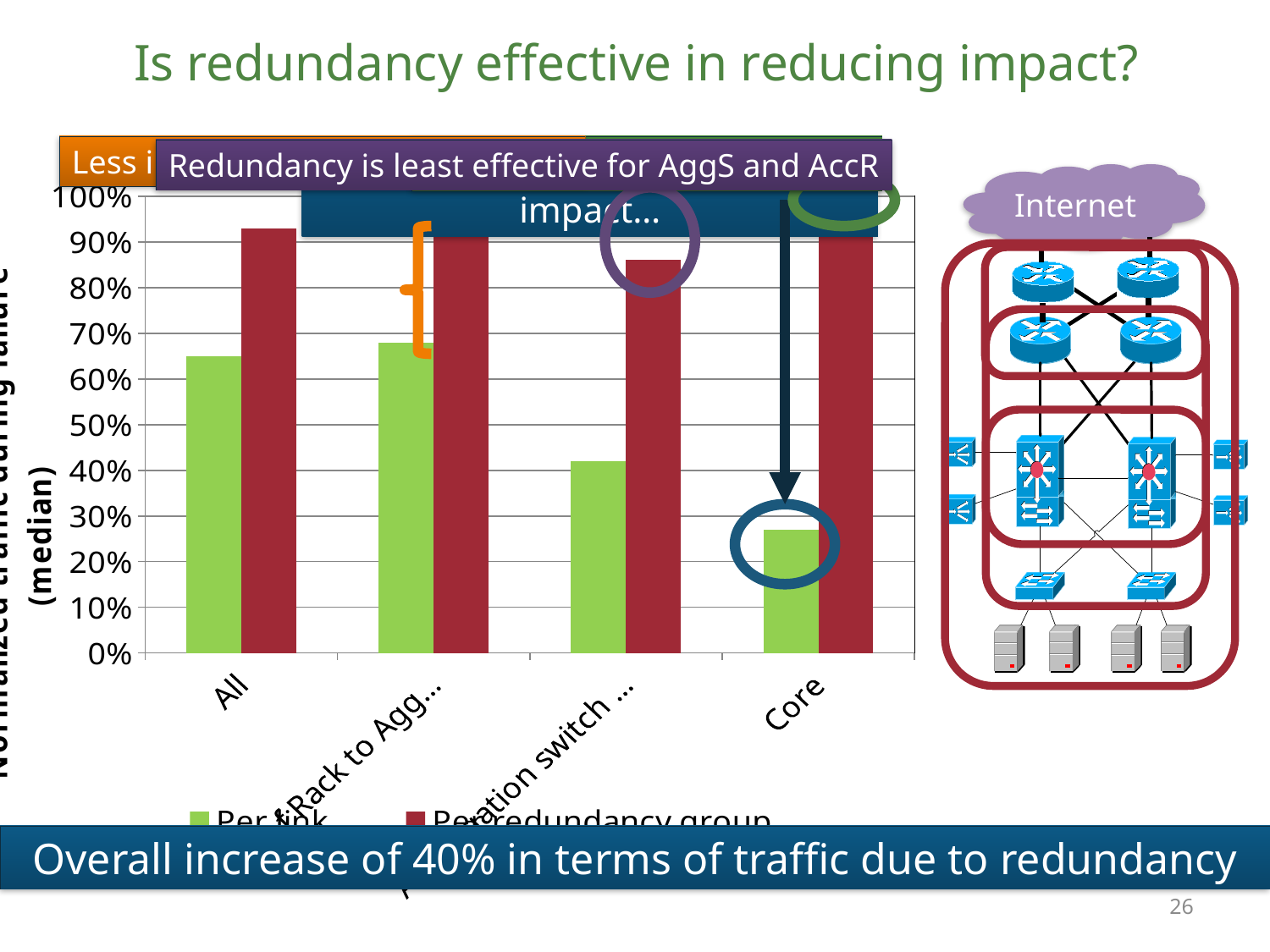
How many series does the chart legend list? 2 For the All category, which is larger: the Per link value or the Per redundancy group value? Per redundancy group How many categories are plotted along the x axis of the chart? 4 What colour are the Per link bars in the chart? green Is the Per redundancy group value for Core greater or less than 80%? greater What is the title of the slide containing the chart? Is redundancy effective in reducing impact? Is the Per redundancy group value for All greater or less than 80%? greater What kind of chart is shown on the slide? bar chart Is the Per link value for All greater or less than 60%? greater Which is larger: the Per link value for All or the Per link value for Core? All Which category has the lowest Per link value? Core